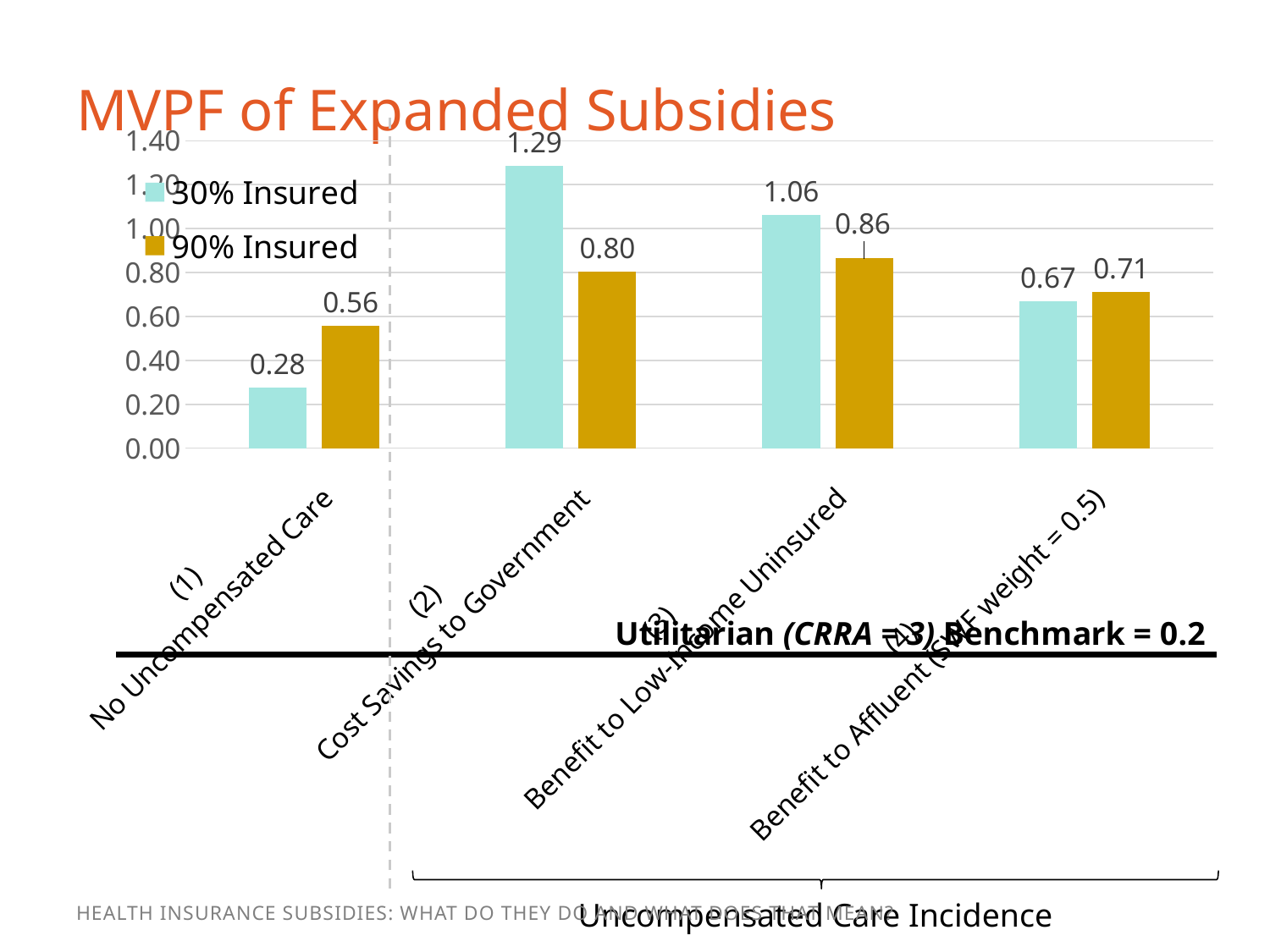
In the No Uncompensated Care category, which series has the larger value, 30% Insured or 90% Insured? 90% Insured What is the difference between the 30% Insured and 90% Insured values in the Cost Savings to Government category? 0.49 What is the title of the chart? MVPF of Expanded Subsidies What is the value for 90% Insured in the Benefit to Affluent category? 0.71 How many series does the legend list? 2 What kind of chart is shown on the slide? Bar chart What is the value for 30% Insured in the Benefit to Low-Income Uninsured category? 1.06 What is the value for 30% Insured in the No Uncompensated Care category? 0.28 Which category has the lowest value for the 90% Insured series? No Uncompensated Care What is the value for 90% Insured in the Cost Savings to Government category? 0.80 How many categories are shown on the x axis of the chart? 4 Which category has the highest value for the 30% Insured series? Cost Savings to Government